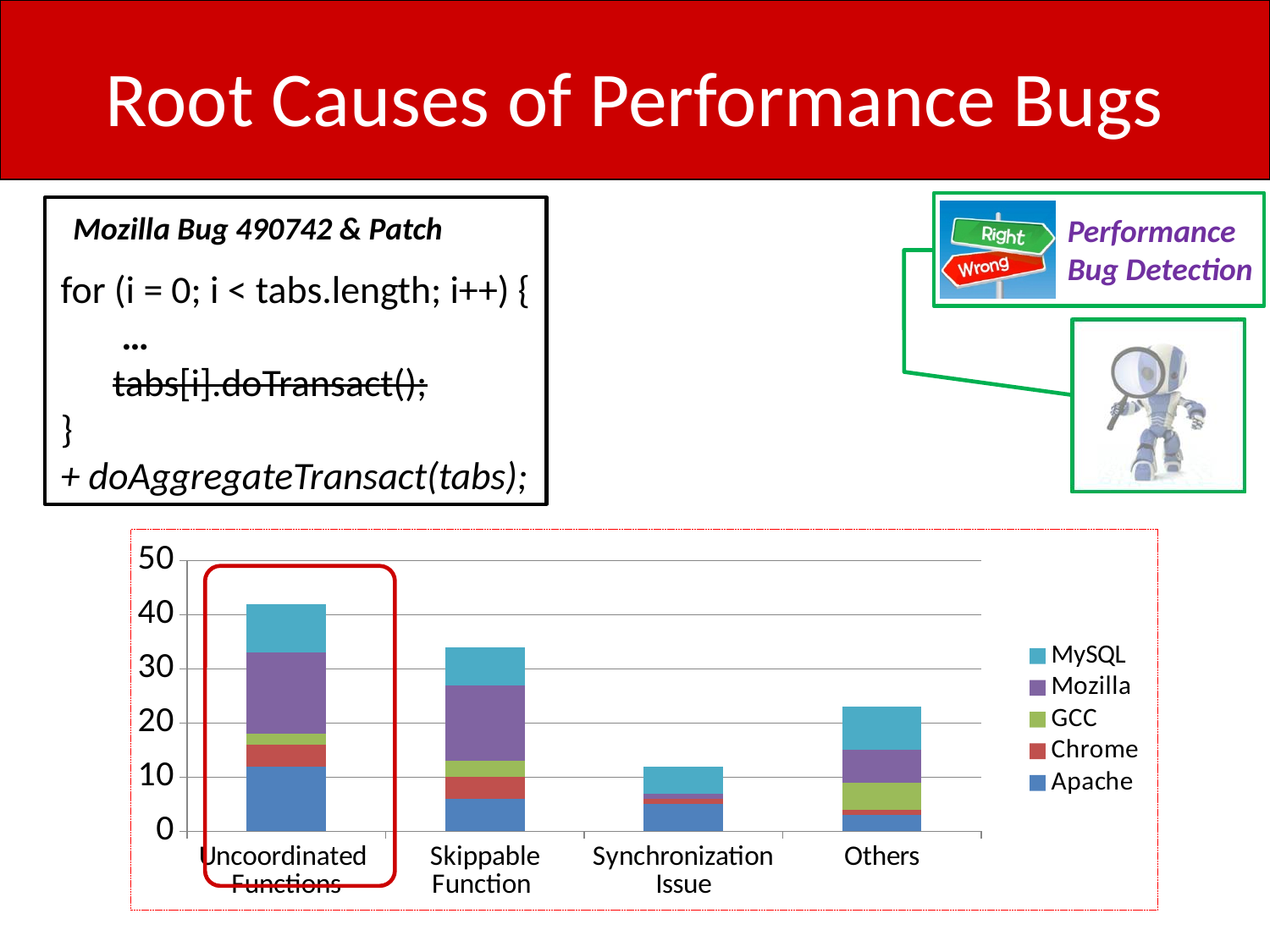
How many series does the chart's legend list? 5 Which category has the tallest stacked bar? Uncoordinated Functions Which series is plotted at the bottom of each stacked bar? Apache Which stacked bar is taller, Skippable Function or Others? Skippable Function Is the total stacked value for Uncoordinated Functions greater or less than 30? greater What kind of chart is shown on the slide? stacked bar chart Which category on the chart is highlighted with a red rounded box? Uncoordinated Functions Is the total stacked value for Others greater or less than 30? less Is the total stacked value for Synchronization Issue greater or less than 20? less How many categories are shown on the x axis of the chart? 4 Which category has the shortest stacked bar? Synchronization Issue